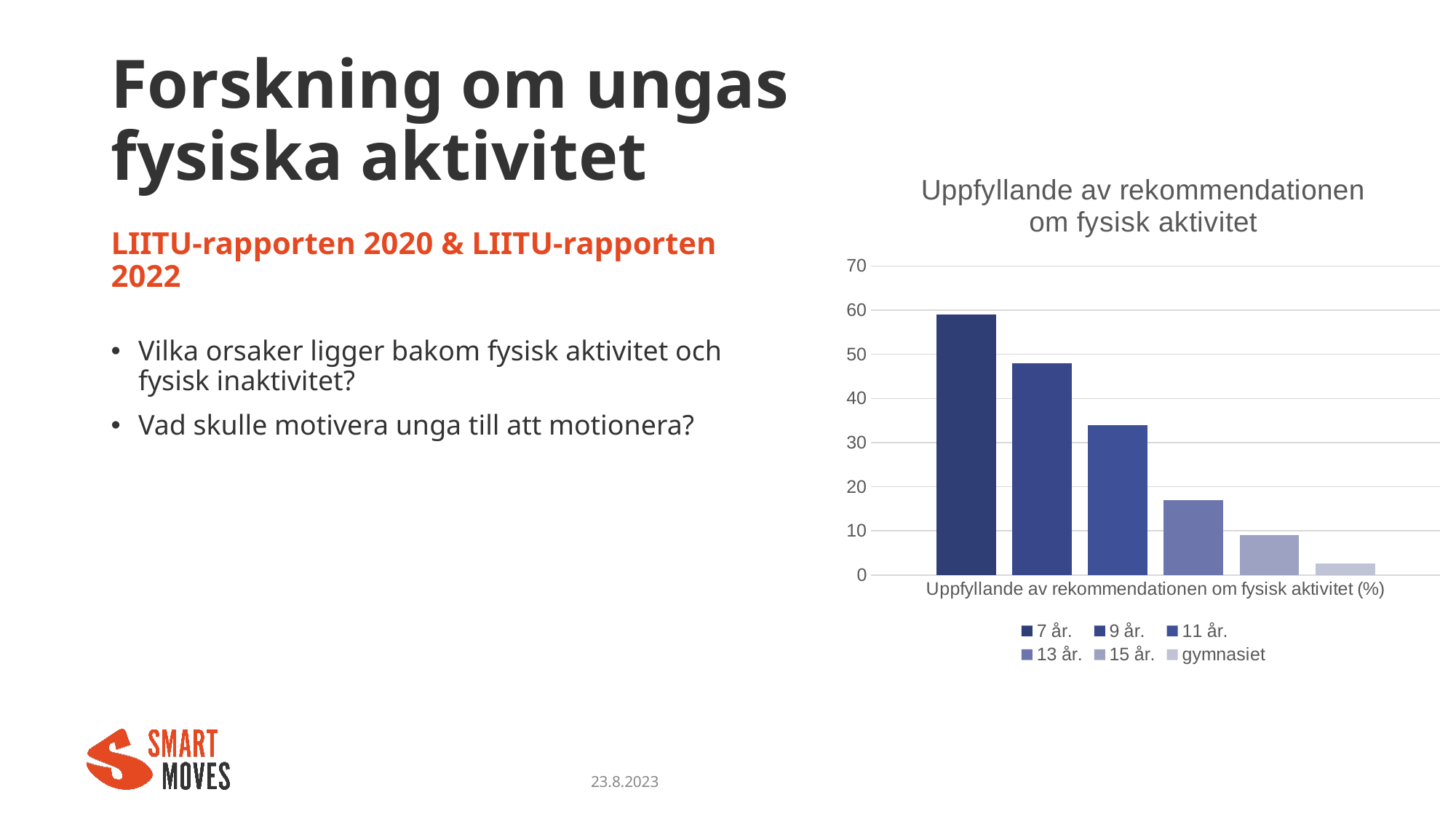
How many series does the chart legend list? 6 Is the value for 11 år. greater or less than 40? less Is the value for 7 år. greater or less than 50? greater What is the title of the chart? Uppfyllande av rekommendationen om fysisk aktivitet Do the values rise or fall as the age groups go from 7 år. to gymnasiet? fall What kind of chart is shown on the slide? bar chart Which group has the lowest value in the chart? gymnasiet Is the value for 13 år. greater or less than 20? less How many bars are plotted in the chart? 6 Which is larger, the value for 13 år. or the value for 15 år.? 13 år. Which age group has the highest value in the chart? 7 år.